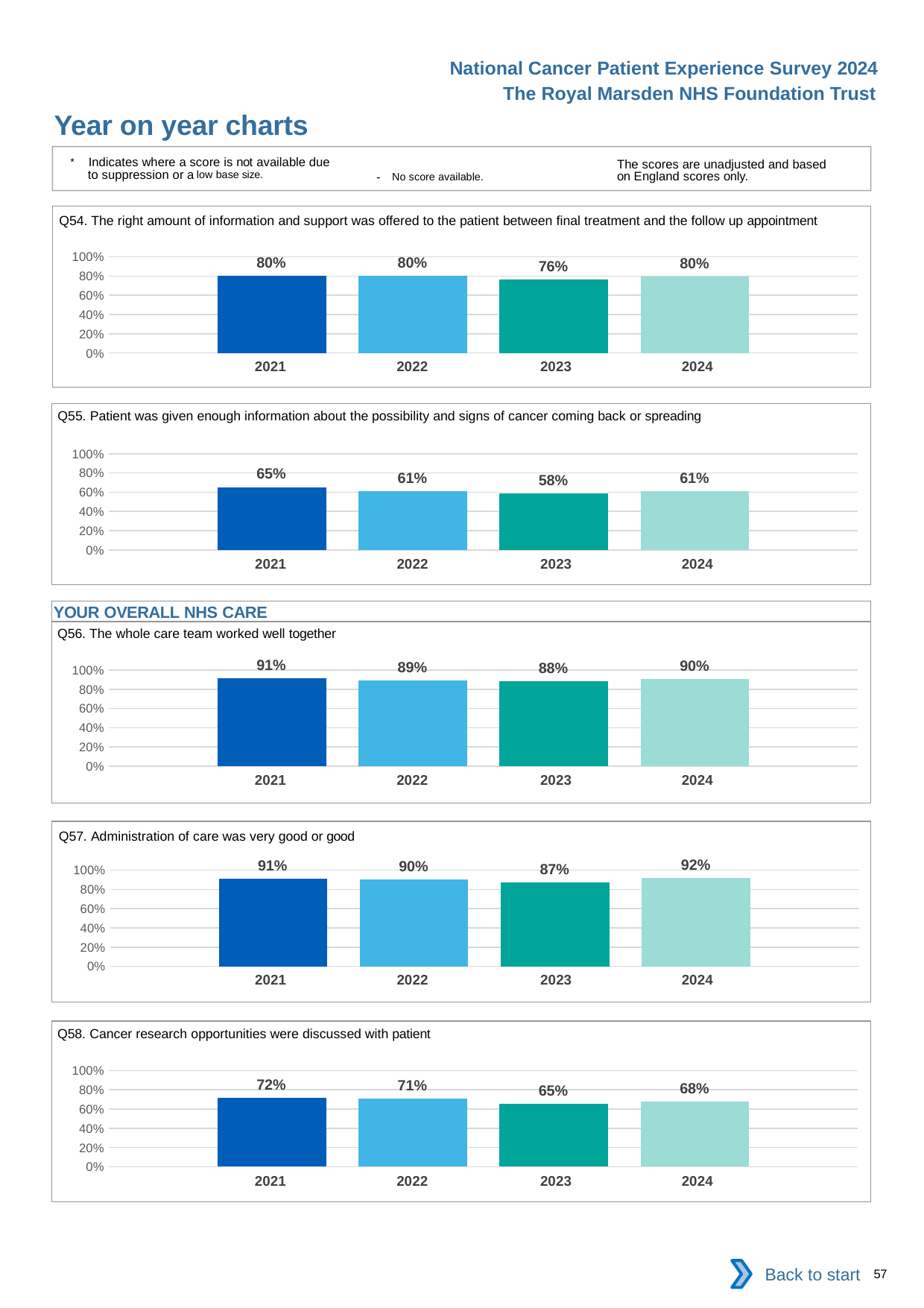
In the Q58 chart, is the value for 2023 greater or less than 80%? less In the Q57 chart, what is the difference between the 2024 value and the 2023 value? 5% How many years are shown on the x axis of the Q57 chart? 4 In the Q55 chart, which year has the lowest value? 2023 In the Q54 chart, what is the value for 2023? 76% In the Q58 chart, what is the value for 2024? 68% In the Q56 chart, what is the difference between the 2021 value and the 2023 value? 3% What kind of chart is the Q56 chart? bar chart In the Q57 chart, which is larger, the value for 2022 or the value for 2024? 2024 In the Q58 chart, do the values rise or fall from 2021 to 2023? fall In the Q55 chart, which year has the highest value? 2021 What is the section heading shown above the Q56 chart? YOUR OVERALL NHS CARE